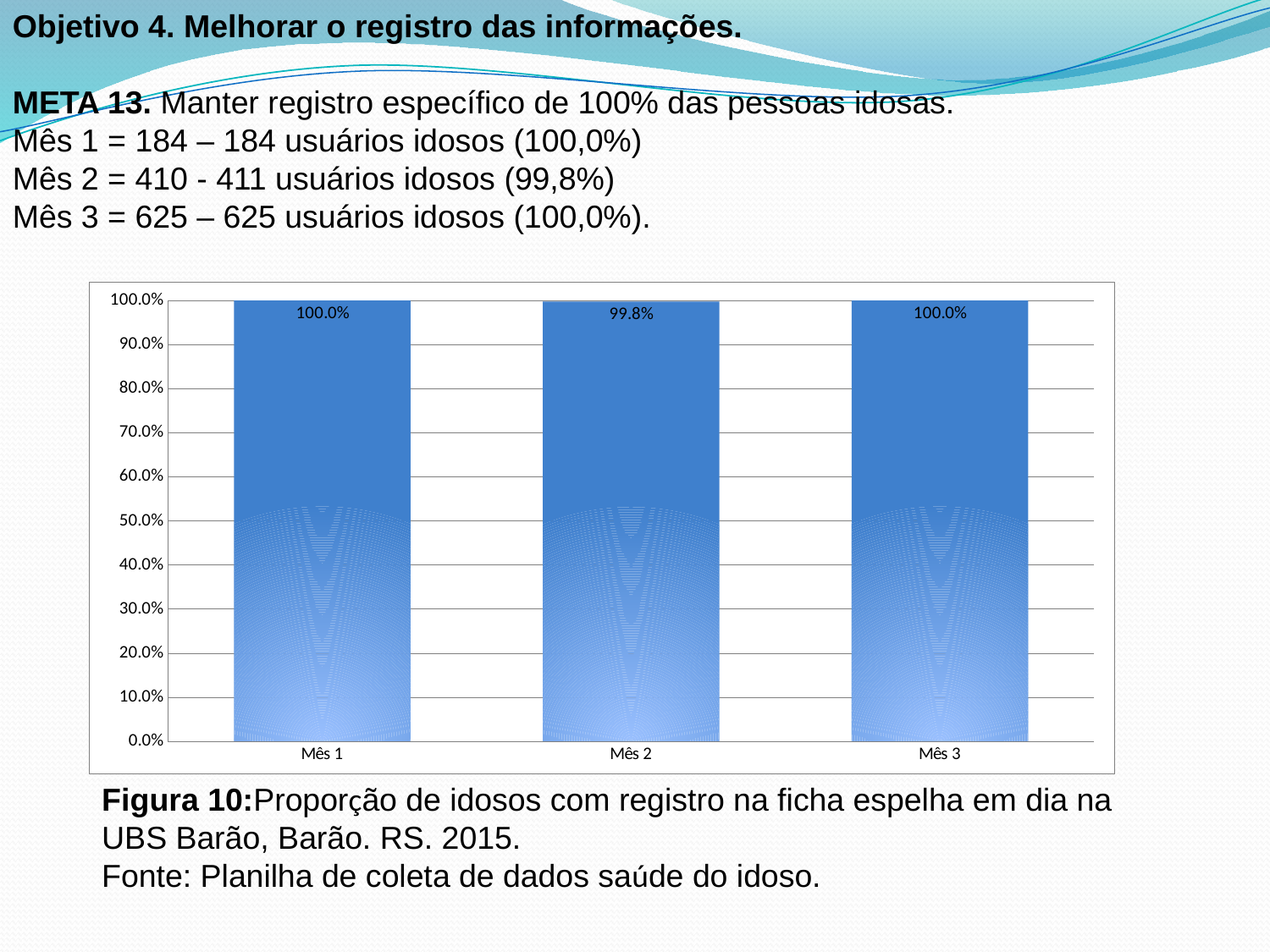
What is the difference between the values for Mês 1 and Mês 2? 0.2% Which is larger, the value for Mês 2 or the value for Mês 3? Mês 3 What is the value for Mês 2? 99.8% What is the value for Mês 1? 100.0% Which month has the lowest value? Mês 2 How many categories are shown on the x axis? 3 What figure number is given in the caption below the chart? Figura 10 What is the value for Mês 3? 100.0% Is the value for Mês 2 greater or less than 90.0%? greater What kind of chart is shown on the slide? bar chart What is the highest tick value shown on the y axis? 100.0%